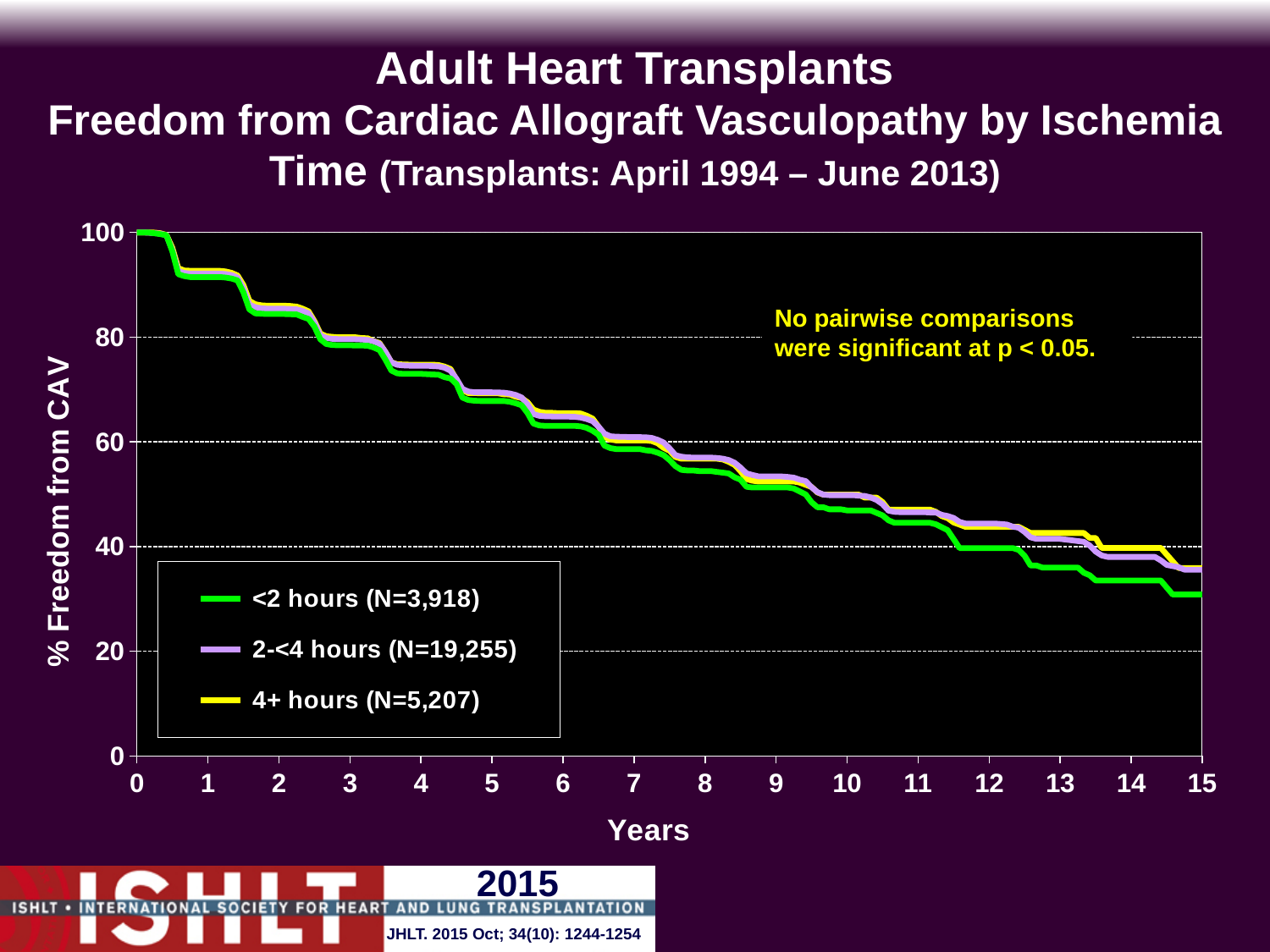
Is the value for the 4+ hours group at year 5 greater or less than 60? greater What is the % Freedom from CAV for all three ischemia time groups at year 0? 100 What is the N for the 2-<4 hours group shown in the legend? 19,255 Is the value for the 2-<4 hours group at year 1 greater or less than 80? greater Do the values for % Freedom from CAV rise or fall as the years increase? fall What kind of chart is shown on the slide? line chart Is the value for the <2 hours group at year 15 greater or less than 40? less What is the label of the x axis? Years Which ischemia time group has the lowest % Freedom from CAV at year 14? <2 hours How many series does the legend list? 3 At year 15, which is larger: the value for the <2 hours group or the 2-<4 hours group? 2-<4 hours